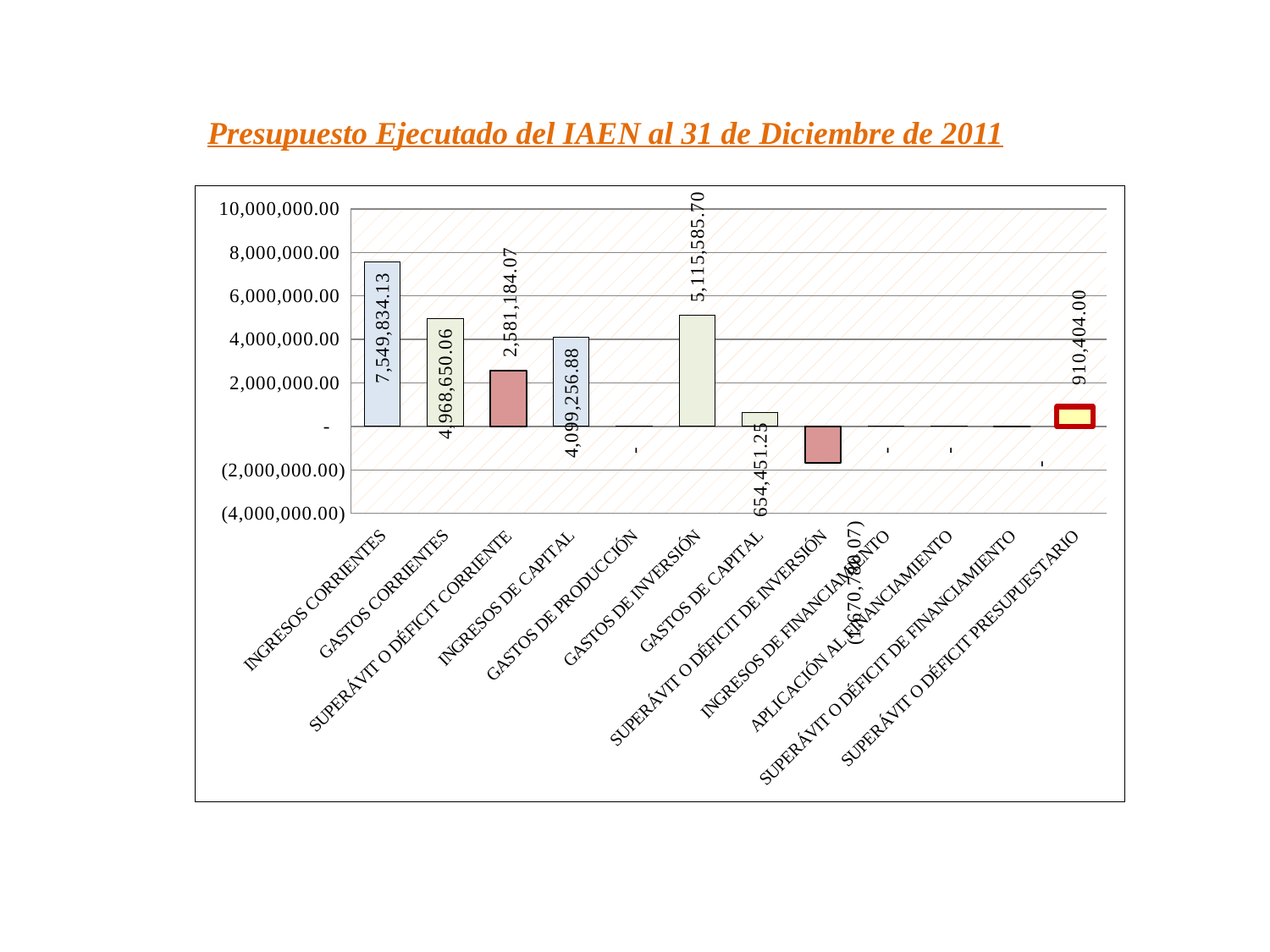
Which is larger, GASTOS DE INVERSIÓN or GASTOS CORRIENTES? GASTOS DE INVERSIÓN Is the value for INGRESOS DE CAPITAL greater or less than 2,000,000.00? greater What is the value for SUPERÁVIT O DÉFICIT PRESUPUESTARIO? 910,404.00 Which category has the lowest value? SUPERÁVIT O DÉFICIT DE INVERSIÓN Which category has the highest value? INGRESOS CORRIENTES What is the value for INGRESOS CORRIENTES? 7,549,834.13 What is the title of the slide? Presupuesto Ejecutado del IAEN al 31 de Diciembre de 2011 What is the value for GASTOS DE INVERSIÓN? 5,115,585.70 What is the difference between INGRESOS CORRIENTES and GASTOS CORRIENTES? 2,581,184.07 How many categories are shown on the x axis? 12 What kind of chart is shown on the slide? bar chart What is the value for GASTOS DE CAPITAL? 654,451.25